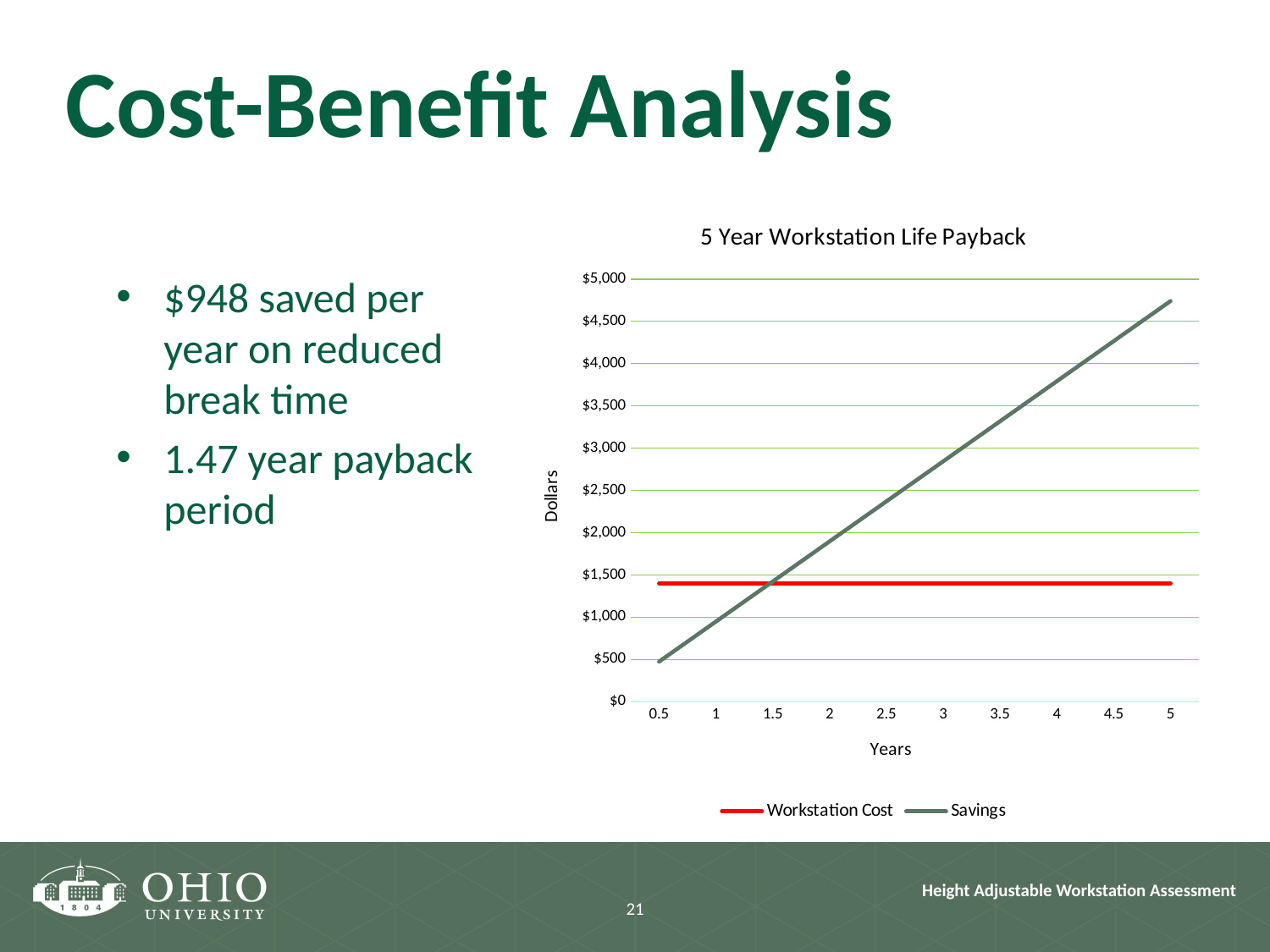
How many points are marked along the Years axis of the chart? 10 Does the Savings line rise or fall as the years increase? Rises At year 1, which is larger: Savings or Workstation Cost? Workstation Cost Is the Savings value at year 5 greater or less than $4,500? greater What is the title of the chart? 5 Year Workstation Life Payback Is the Workstation Cost value greater or less than $1,500? less Is the Savings value at year 4 greater or less than $3,500? greater At year 5, which is larger: Savings or Workstation Cost? Savings What kind of chart is shown on the slide? Line chart How many series does the chart legend list? 2 What colour is the Workstation Cost line in the chart? Red